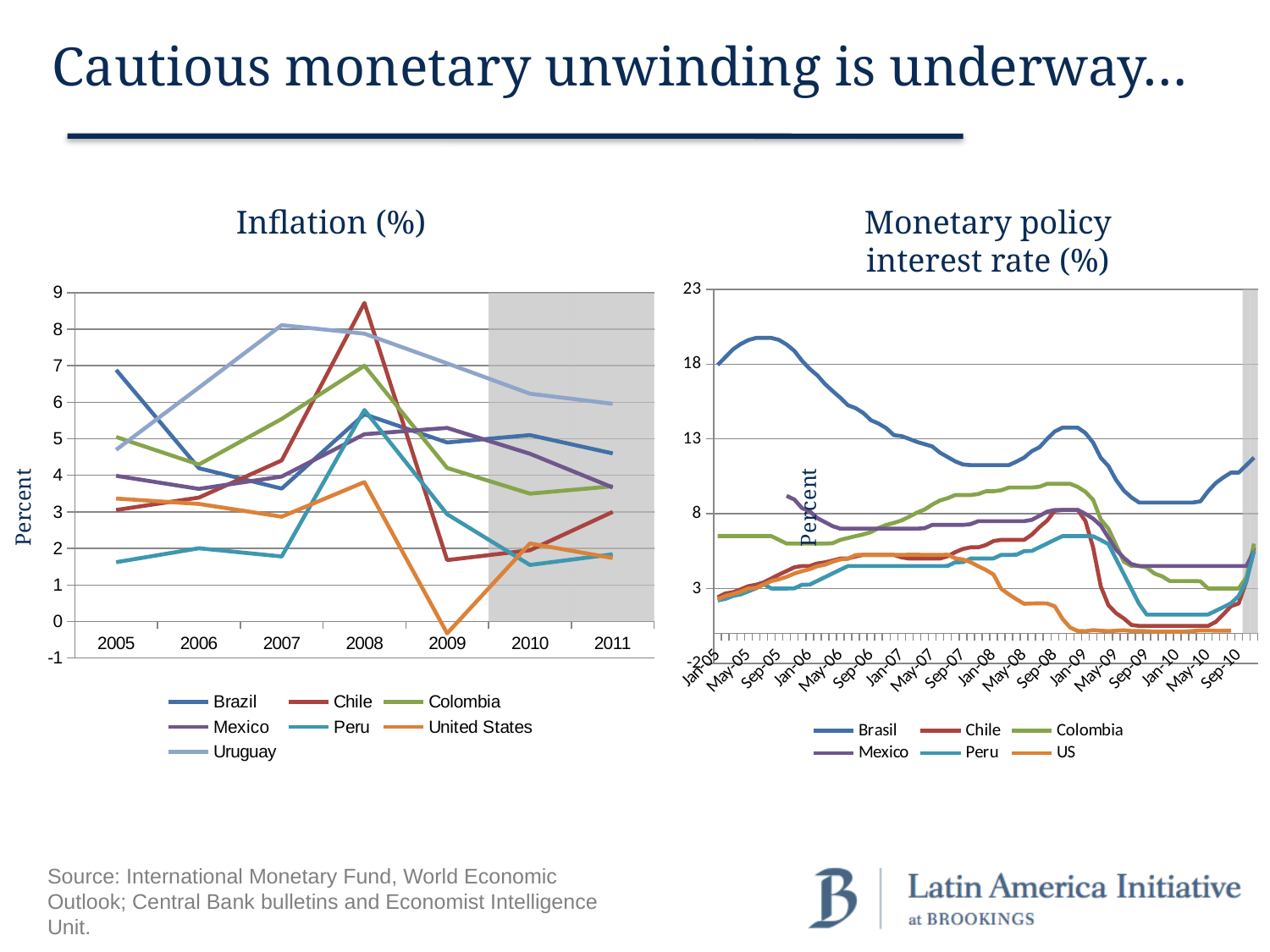
In the Monetary policy interest rate (%) chart, which country has the highest interest rate in Jan-05? Brasil How many series does the legend of the Inflation (%) chart list? 7 In the Inflation (%) chart, which is larger in 2009: Brazil or United States? Brazil How many series does the legend of the Monetary policy interest rate (%) chart list? 6 In the Inflation (%) chart, is the value for Chile in 2008 greater or less than 8? greater In the Inflation (%) chart, does Uruguay's inflation rise or fall from 2007 to 2011? fall In the Monetary policy interest rate (%) chart, is the value for Brasil in Jan-05 greater or less than 13? greater In the Inflation (%) chart, which country has the lowest inflation in 2009? United States What kind of chart is the Inflation (%) chart? line chart In the Inflation (%) chart, is the value for the United States in 2009 greater or less than 1? less How many years are shown on the x axis of the Inflation (%) chart? 7 In the Inflation (%) chart, which country has the highest inflation in 2008? Chile